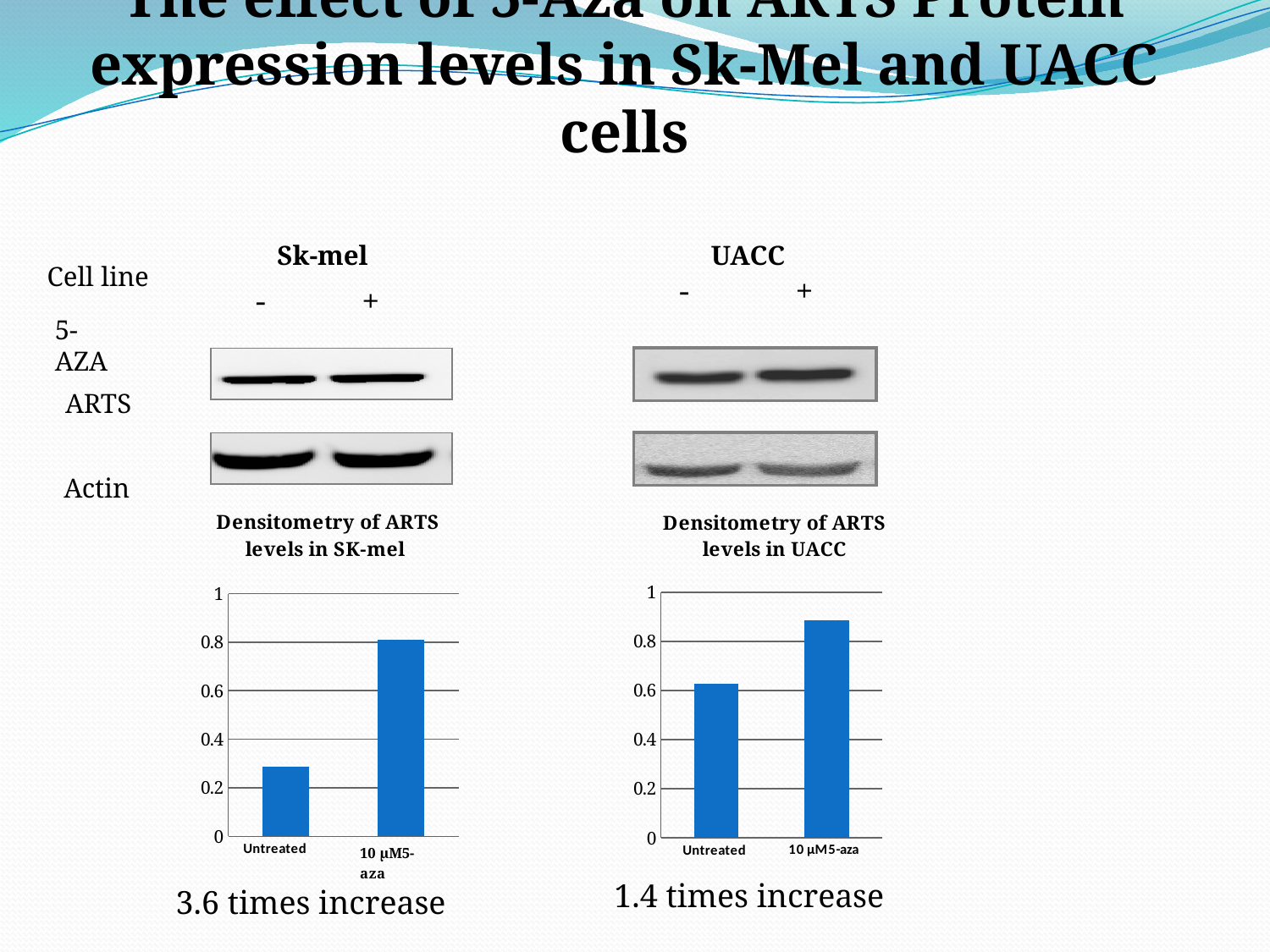
What kind of chart is the 'Densitometry of ARTS levels in UACC' chart? bar chart In the 'Densitometry of ARTS levels in UACC' chart, is the value for 10 µM 5-aza greater or less than 0.8? greater In the 'Densitometry of ARTS levels in SK-mel' chart, is the value for 10 µM 5-aza greater or less than 0.6? greater In the 'Densitometry of ARTS levels in UACC' chart, which is larger, the value for Untreated or the value for 10 µM 5-aza? 10 µM 5-aza In the 'Densitometry of ARTS levels in SK-mel' chart, is the value for Untreated greater or less than 0.4? less In the 'Densitometry of ARTS levels in SK-mel' chart, which category has the highest value? 10 µM 5-aza What is the title of the bar chart on the right side of the slide? Densitometry of ARTS levels in UACC In the 'Densitometry of ARTS levels in SK-mel' chart, do the values rise or fall from Untreated to 10 µM 5-aza? rise In the 'Densitometry of ARTS levels in SK-mel' chart, which category has the lowest value? Untreated In the 'Densitometry of ARTS levels in UACC' chart, which category has the highest value? 10 µM 5-aza How many categories are shown in the 'Densitometry of ARTS levels in SK-mel' chart? 2